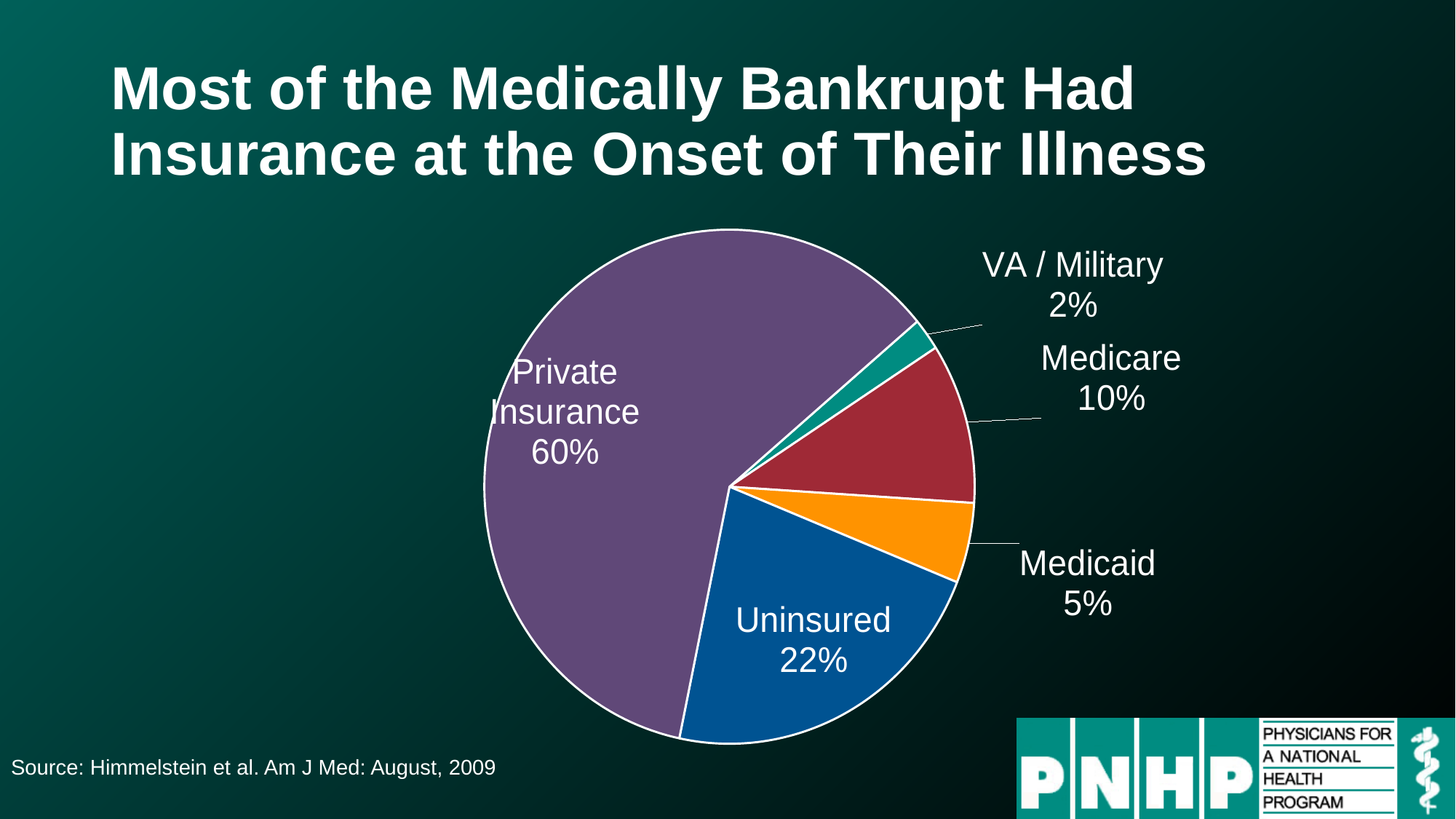
What is the value shown for Medicare? 10% What is the difference in percentage points between Private Insurance and Uninsured? 38 What percentage of the medically bankrupt were Uninsured? 22% Which category has the smallest slice of the pie? VA / Military What is the title of the slide containing the chart? Most of the Medically Bankrupt Had Insurance at the Onset of Their Illness What kind of chart is shown on the slide? Pie chart Which is larger, the Medicare slice or the Medicaid slice? Medicare What is the value shown for Medicaid? 5% Which category has the largest slice of the pie? Private Insurance What is the value shown for VA / Military? 2% How many categories are shown in the pie chart? 5 What share of the pie is Private Insurance? 60%